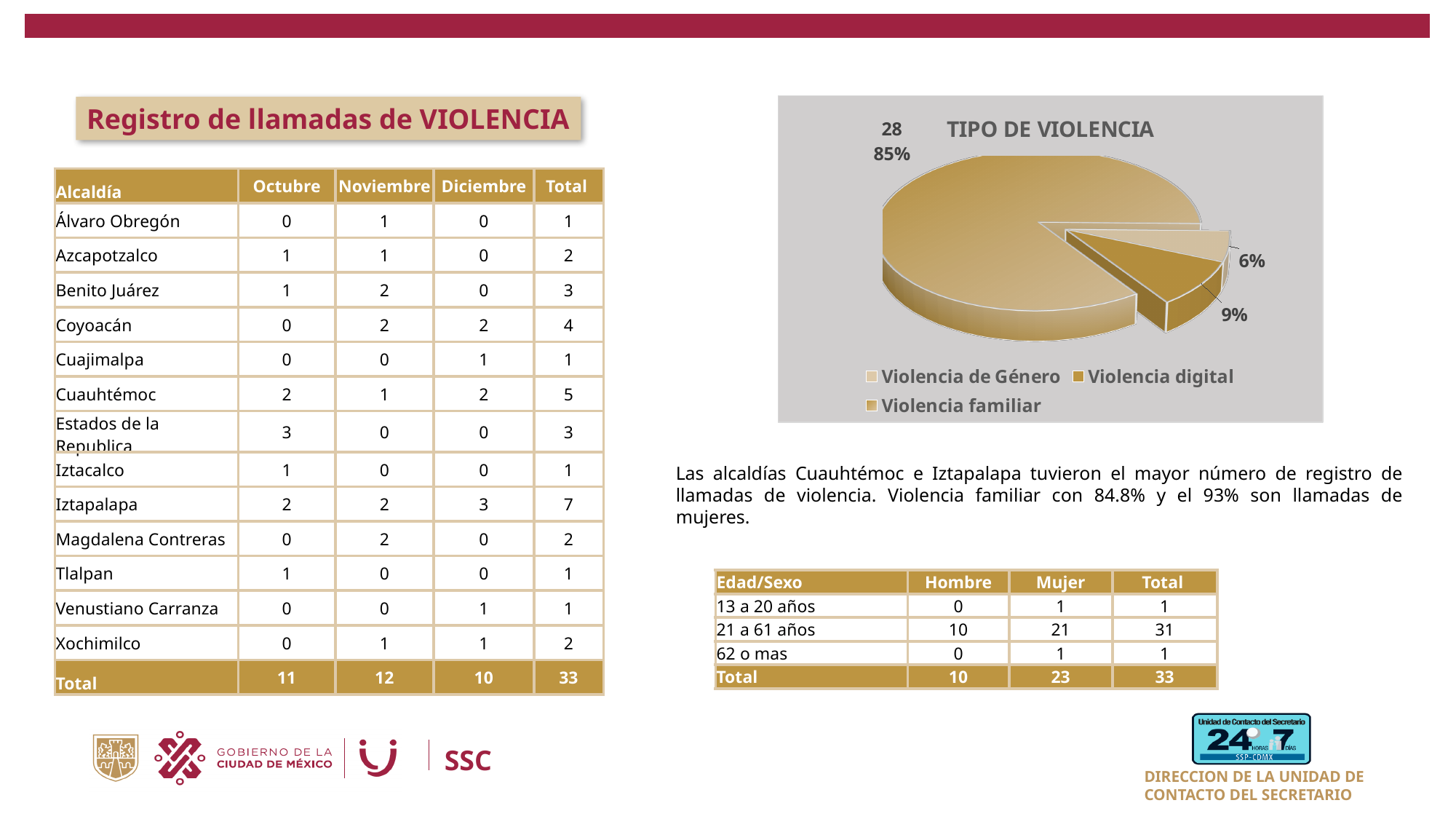
Which of the two small slices of the pie chart is larger, the one labelled 9% or the one labelled 6%? 9% Which type of violence accounts for the largest slice of the pie chart? Violencia familiar What is the title of the pie chart? TIPO DE VIOLENCIA What is the largest percentage shown on the pie chart? 85% What is the smallest percentage shown on the pie chart? 6% How many categories does the legend of the pie chart list? 3 What is the difference in percentage points between the 9% slice and the 6% slice of the pie chart? 3% What kind of chart is shown on the slide? pie chart What count is printed next to the 85% slice of the pie chart? 28 What are the three legend entries of the pie chart? Violencia de Género, Violencia digital, Violencia familiar Is the share of the largest slice of the pie chart greater or less than 50%? greater How many slices does the pie chart have? 3